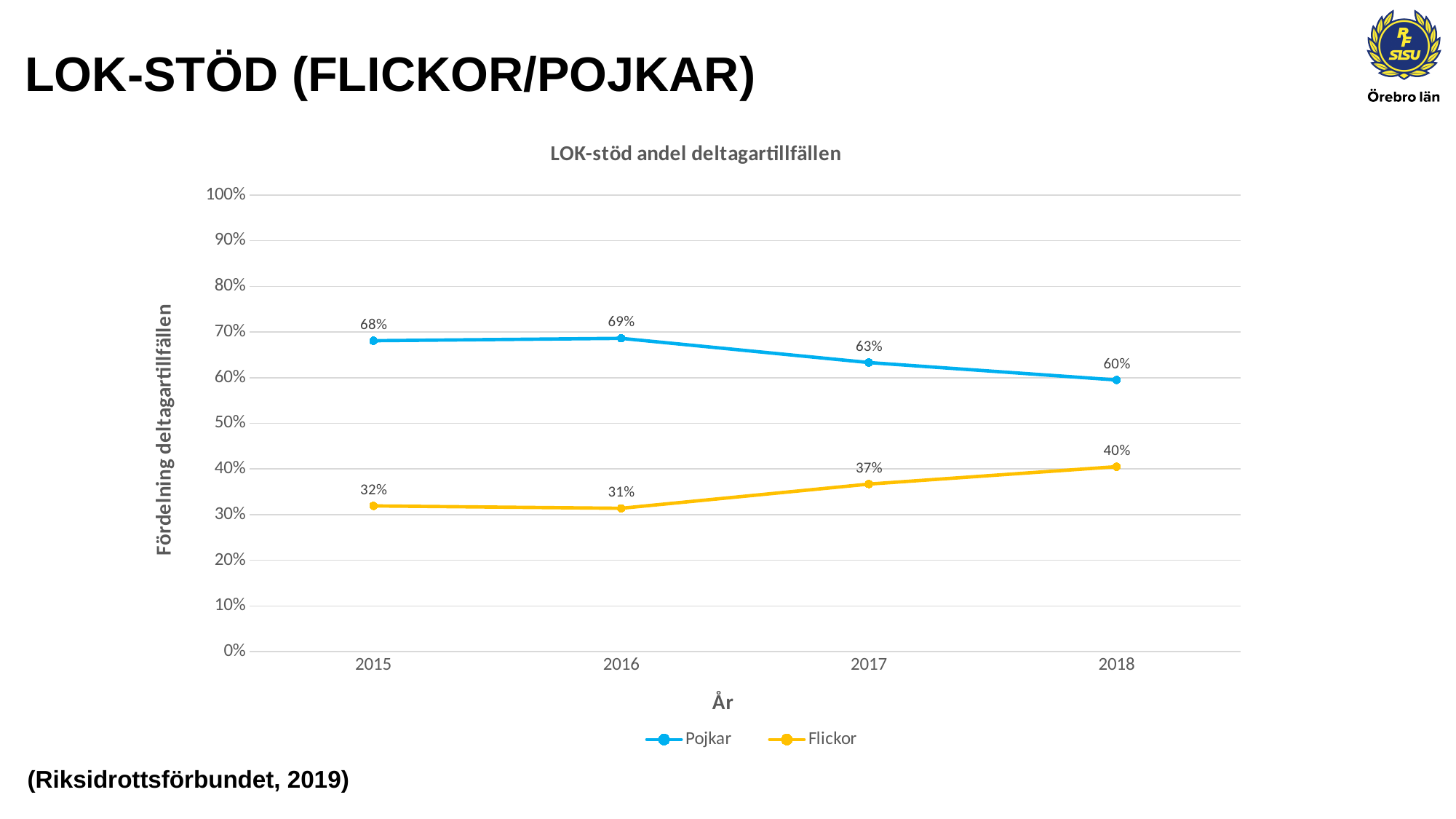
Is the value for Flickor in 2017 greater or less than 40%? less Which series has the larger value in 2018, Pojkar or Flickor? Pojkar How many years are shown on the x axis? 4 In which year is the Flickor value lowest? 2016 In which year is the Pojkar value highest? 2016 Does the Flickor series rise or fall from 2016 to 2018? rise How many series does the legend list? 2 What is the difference between the Pojkar and Flickor values in 2017? 26% What kind of chart is shown? line chart What is the value for Pojkar in 2015? 68% What is the value for Flickor in 2018? 40% What is the value for Flickor in 2016? 31%